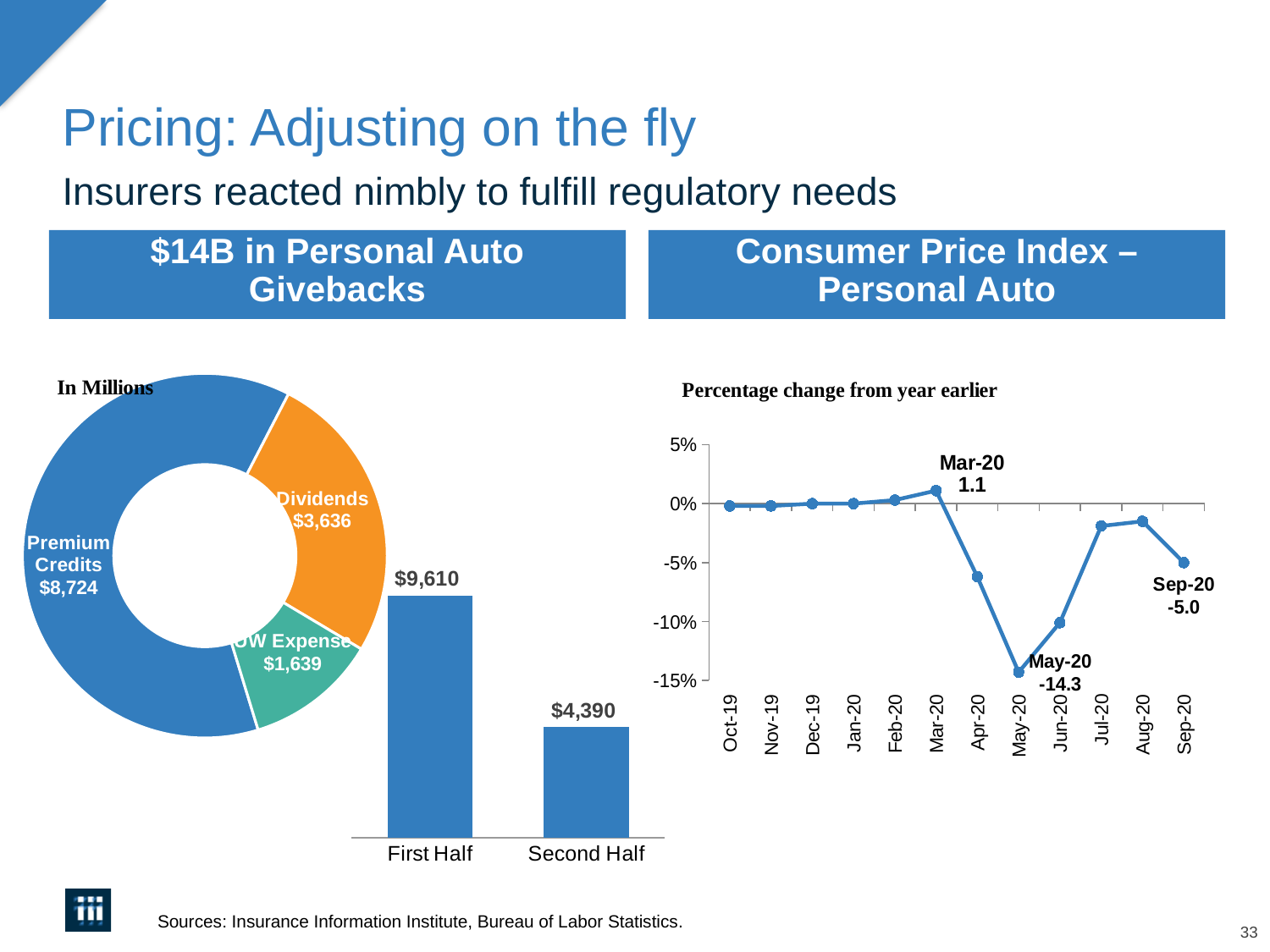
In the donut chart on the left, which category has the smallest value? UW Expense In the Consumer Price Index – Personal Auto chart, which month has the lowest value? May-20 In the donut chart on the left, what is the value for Dividends? $3,636 In the donut chart on the left, what is the difference between Premium Credits and Dividends? $5,088 In the Consumer Price Index – Personal Auto chart, what is the value for May-20? -14.3 In the donut chart on the left, what is the value for Premium Credits? $8,724 In the donut chart on the left, how many categories are shown? 3 In the bar chart showing First Half and Second Half, what is the value for Second Half? $4,390 In the bar chart showing First Half and Second Half, which bar is larger? First Half In the bar chart showing First Half and Second Half, what is the difference between First Half and Second Half? $5,220 In the Consumer Price Index – Personal Auto chart, is the value for Apr-20 greater or less than -5%? less In the Consumer Price Index – Personal Auto chart, what is the value for Sep-20? -5.0